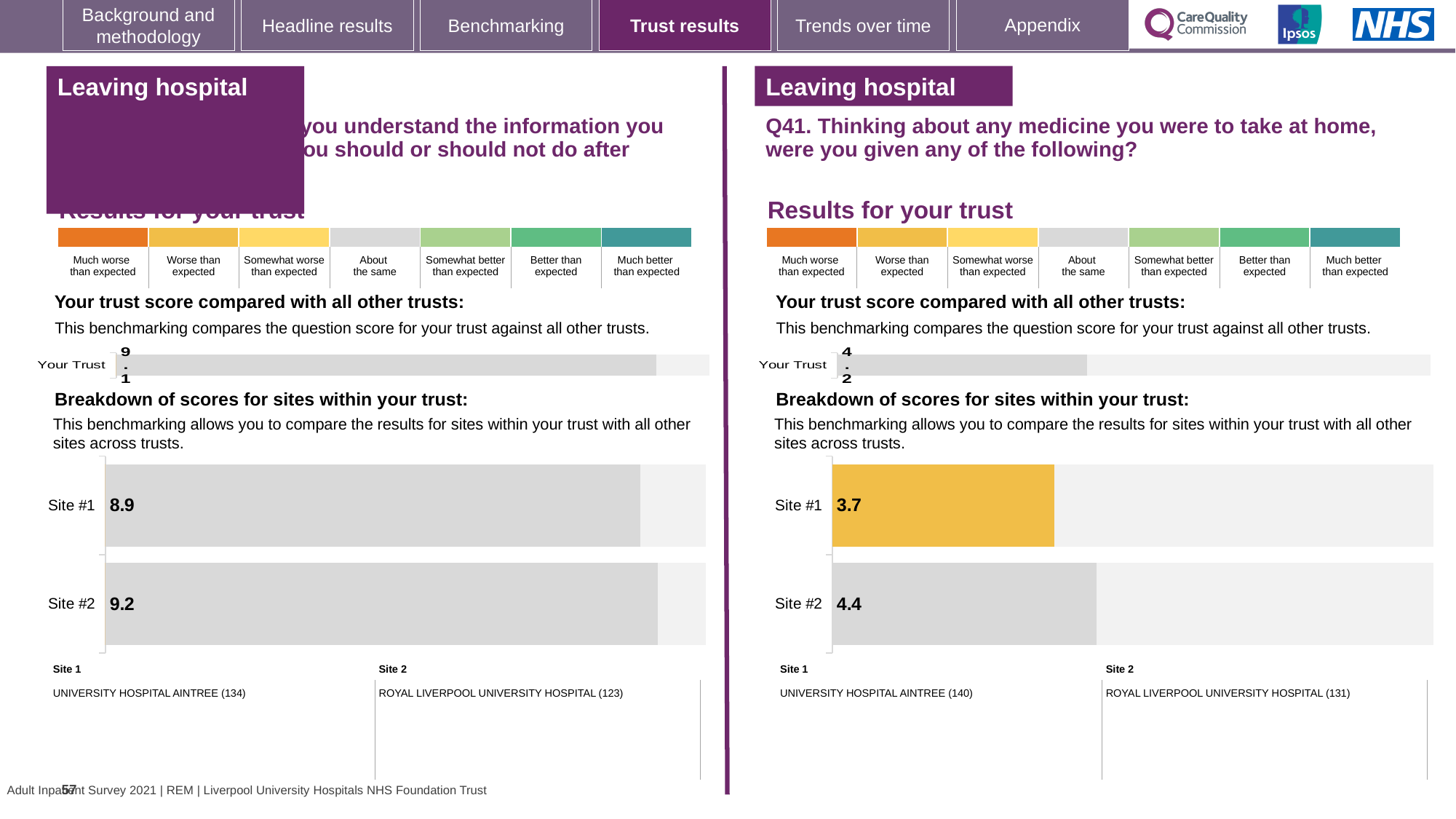
In the right-hand chart for Q41, what is the score for Site #2? 4.4 In the left-hand site breakdown chart, is the score for Site #1 larger or smaller than the score for Site #2? smaller In the left-hand site breakdown chart, what is the score for Site #2? 9.2 How many sites are shown in the right-hand site breakdown chart for Q41? 2 In the right-hand chart for Q41, what colour is the bar for Site #1? yellow In the left-hand site breakdown chart, which site has the lower score? Site #1 In the left-hand site breakdown chart, what is the difference between the Site #2 and Site #1 scores? 0.3 In the right-hand chart for Q41, what is the difference between the Site #2 and Site #1 scores? 0.7 In the right-hand chart for Q41, which site has the higher score? Site #2 In the right-hand chart for Q41 (medicine to take at home), what is the score for Site #1? 3.7 What type of chart is used for the site breakdown on the right-hand side of the slide? bar chart In the left-hand site breakdown chart, what is the score for Site #1? 8.9